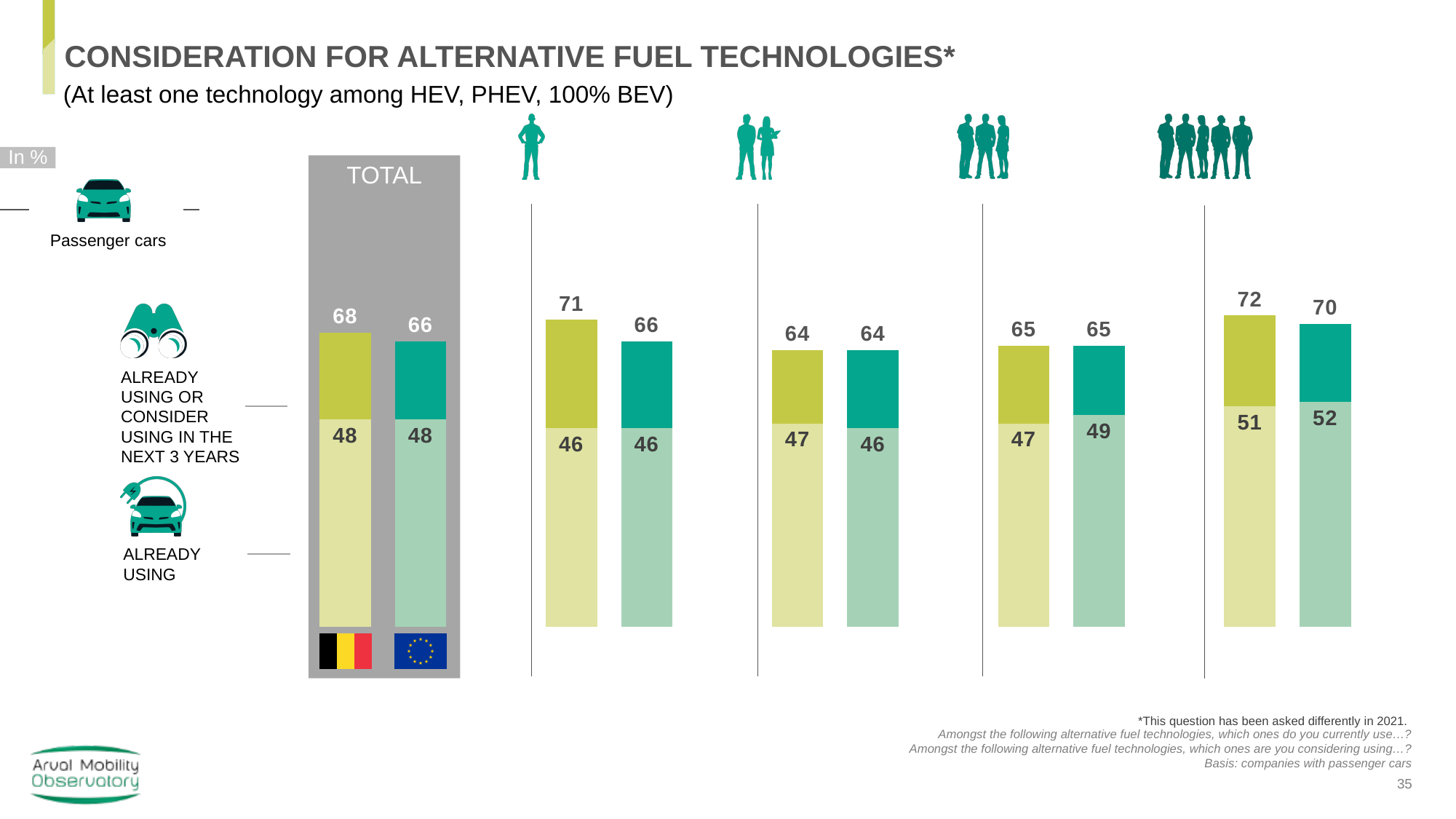
How many groups of bars are shown on the chart, including TOTAL? 5 In the TOTAL column, what is the difference between the Belgium and Europe 'already using or consider using' values? 2 What is the Belgium value for 'already using or consider using in the next 3 years' in the TOTAL column? 68 In the rightmost group (five-person icon), which is larger for 'already using or consider using': Belgium or Europe? Belgium What is the Europe (EU flag) value for 'already using' in the TOTAL column? 48 Among the Belgium bars, which group has the lowest 'already using or consider using' value? The second group of people icons (two-person icon), 64 Among the Belgium bars, which group has the highest 'already using or consider using' value? The rightmost group (five-person icon), 72 In what unit are the chart values expressed? In % What kind of chart is shown on the slide? Bar chart In the rightmost group (five-person icon), what is the difference between Belgium's 'already using or consider using' value and its 'already using' value? 21 What is the Europe (EU flag) value for 'already using' in the rightmost group (five-person icon)? 52 How many series (flags) does the chart compare? 2